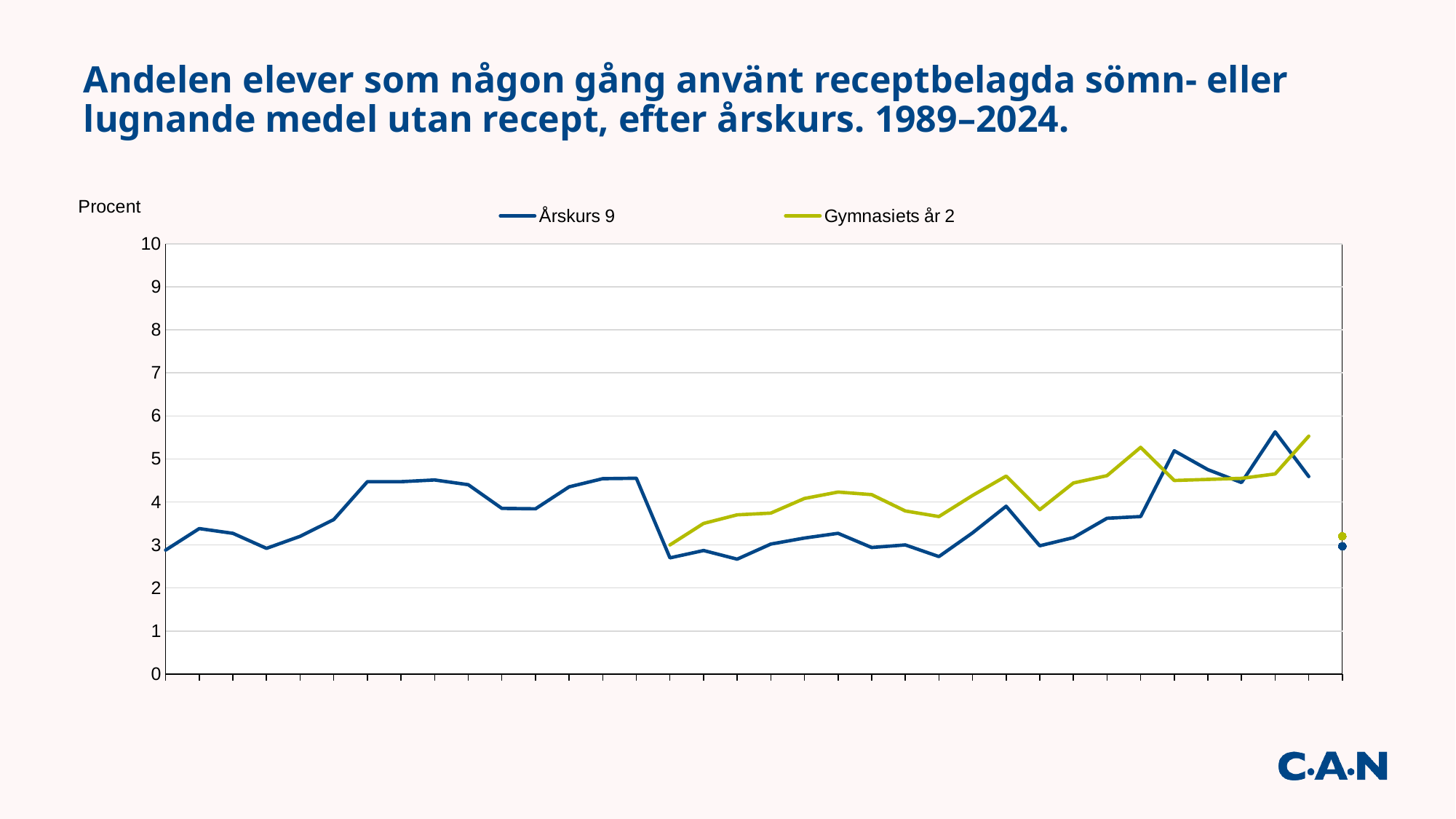
Is the lowest value of the Årskurs 9 line greater or less than 2? greater Is the lowest value of the Gymnasiets år 2 line greater or less than 4? less What are the two series named in the legend? Årskurs 9 and Gymnasiets år 2 Over the whole period, does the Gymnasiets år 2 line generally rise or fall from its first point to its last point? rise Is the highest value reached by the Årskurs 9 line greater or less than 5? greater What is the label on the vertical axis? Procent What kind of chart is shown on the slide? line chart What is the highest value shown on the vertical axis? 10 Which series starts later on the x axis, Årskurs 9 or Gymnasiets år 2? Gymnasiets år 2 How many series does the legend list? 2 At the right end of the chart, which series has the higher value, Årskurs 9 or Gymnasiets år 2? Gymnasiets år 2